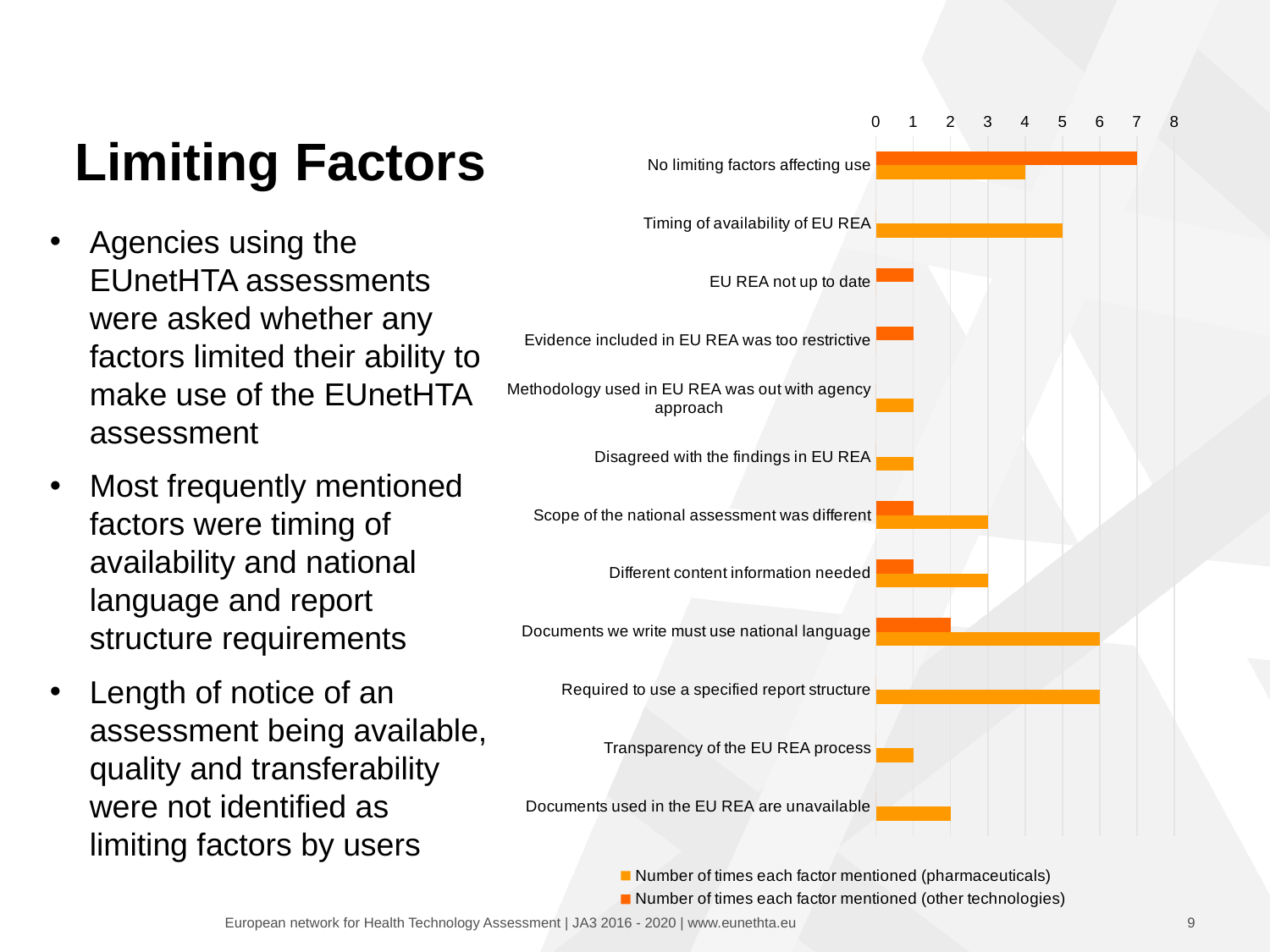
For 'No limiting factors affecting use', which series has the larger value: pharmaceuticals or other technologies? other technologies How many series does the chart legend list? 2 How many times was 'Documents used in the EU REA are unavailable' mentioned for pharmaceuticals? 2 How many factor categories are plotted in the chart? 12 How many times was 'Documents we write must use national language' mentioned for pharmaceuticals? 6 What is the maximum value shown on the chart's horizontal axis? 8 How many times was 'No limiting factors affecting use' mentioned for other technologies? 7 Is the pharmaceuticals value for 'Required to use a specified report structure' greater or less than 4? greater What is the difference between the pharmaceuticals and other technologies values for 'Documents we write must use national language'? 4 Which factor has the highest value for other technologies? No limiting factors affecting use How many times was 'Timing of availability of EU REA' mentioned for pharmaceuticals? 5 What kind of chart is shown on the slide? bar chart